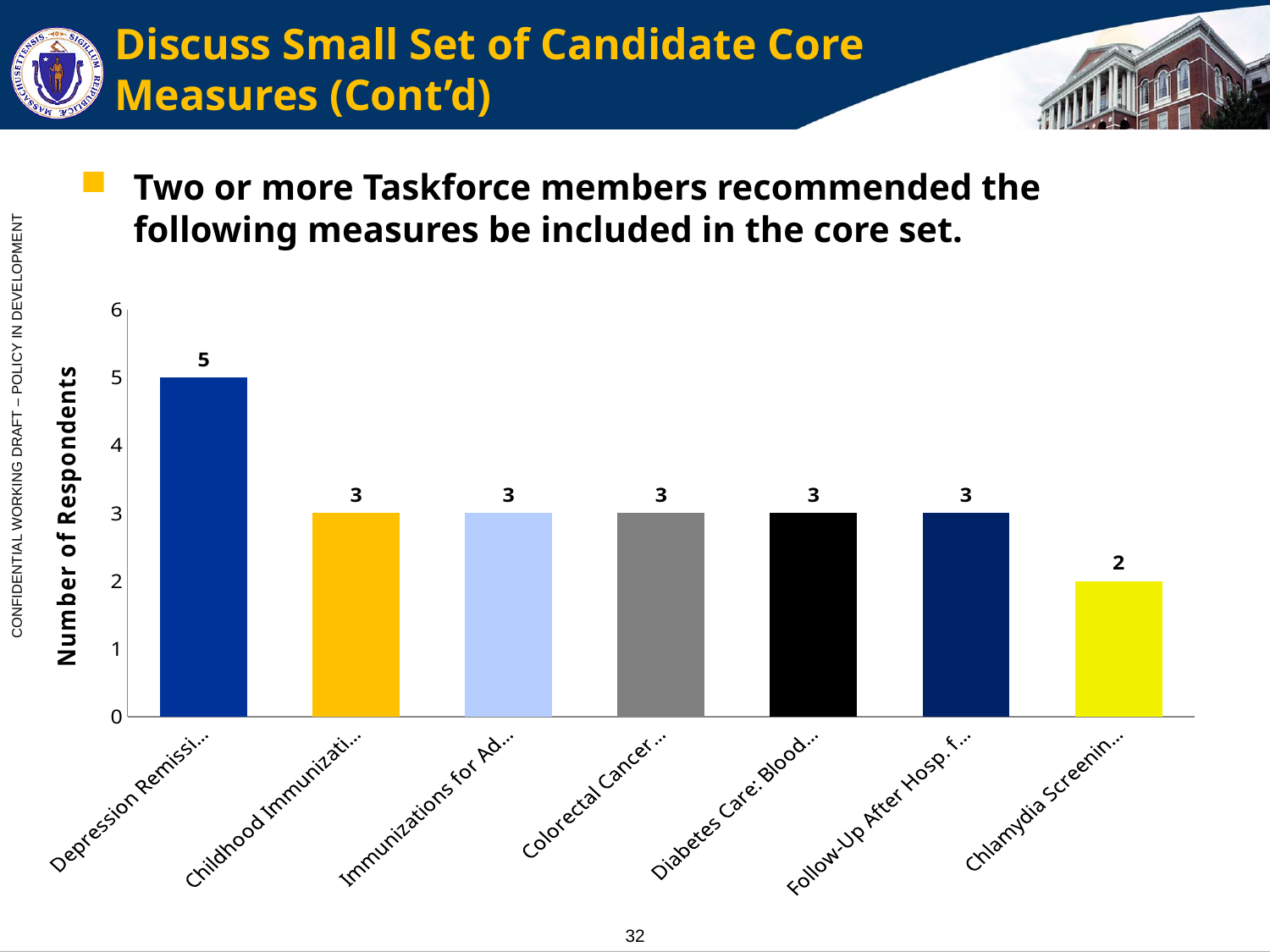
Which has more respondents, "Childhood Immunizati…" or "Chlamydia Screenin…"? Childhood Immunizati… What is the difference in number of respondents between "Depression Remissi…" and "Colorectal Cancer…"? 2 What is the number of respondents for the bar labelled "Chlamydia Screenin…"? 2 Is the value for "Depression Remissi…" greater or less than 4? greater What is the difference in number of respondents between "Depression Remissi…" and "Chlamydia Screenin…"? 3 What is the number of respondents for the bar labelled "Depression Remissi…"? 5 Which measure has the highest number of respondents? Depression Remissi… How many bars have a value of 3? 5 What is the number of respondents for the bar labelled "Colorectal Cancer…"? 3 Which measure has the lowest number of respondents? Chlamydia Screenin… What kind of chart is shown on the slide? bar chart How many measures (bars) are shown in the chart? 7